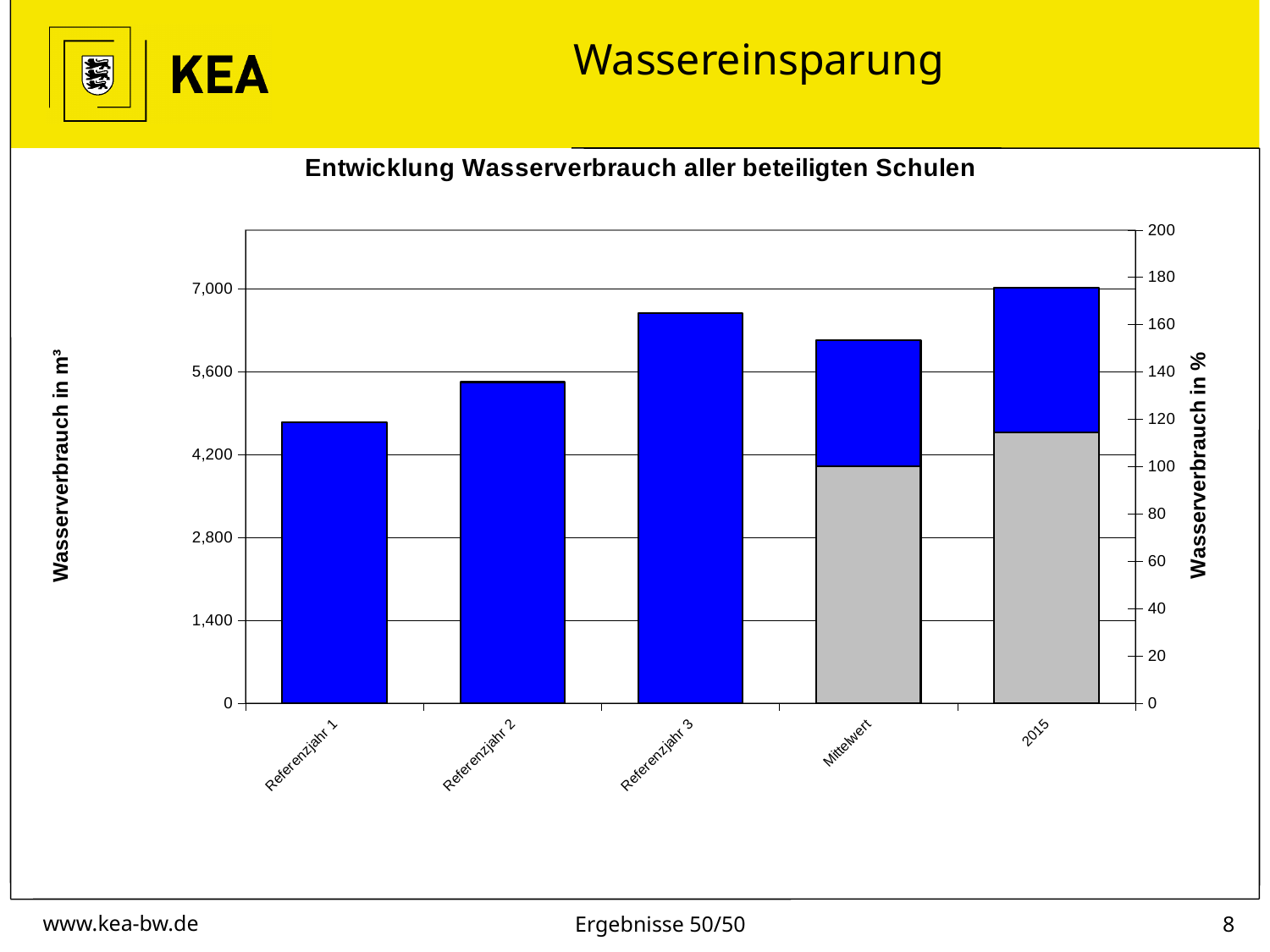
Which category has the tallest blue bar? 2015 Which blue bar is taller, Referenzjahr 2 or Referenzjahr 3? Referenzjahr 3 How many categories are shown on the x axis of the chart? 5 Is the blue bar for Referenzjahr 1 greater or less than 4,200 m³? greater What is the label of the right-hand vertical axis? Wasserverbrauch in % Is the blue bar for Referenzjahr 2 greater or less than 5,600 m³? less What kind of chart is shown on the slide? bar chart Do the blue bars rise or fall from Referenzjahr 1 to Referenzjahr 3? rise What is the title of the chart? Entwicklung Wasserverbrauch aller beteiligten Schulen Is the grey bar for 2015 greater or less than 100 on the right-hand axis? greater Which category has the shortest blue bar? Referenzjahr 1